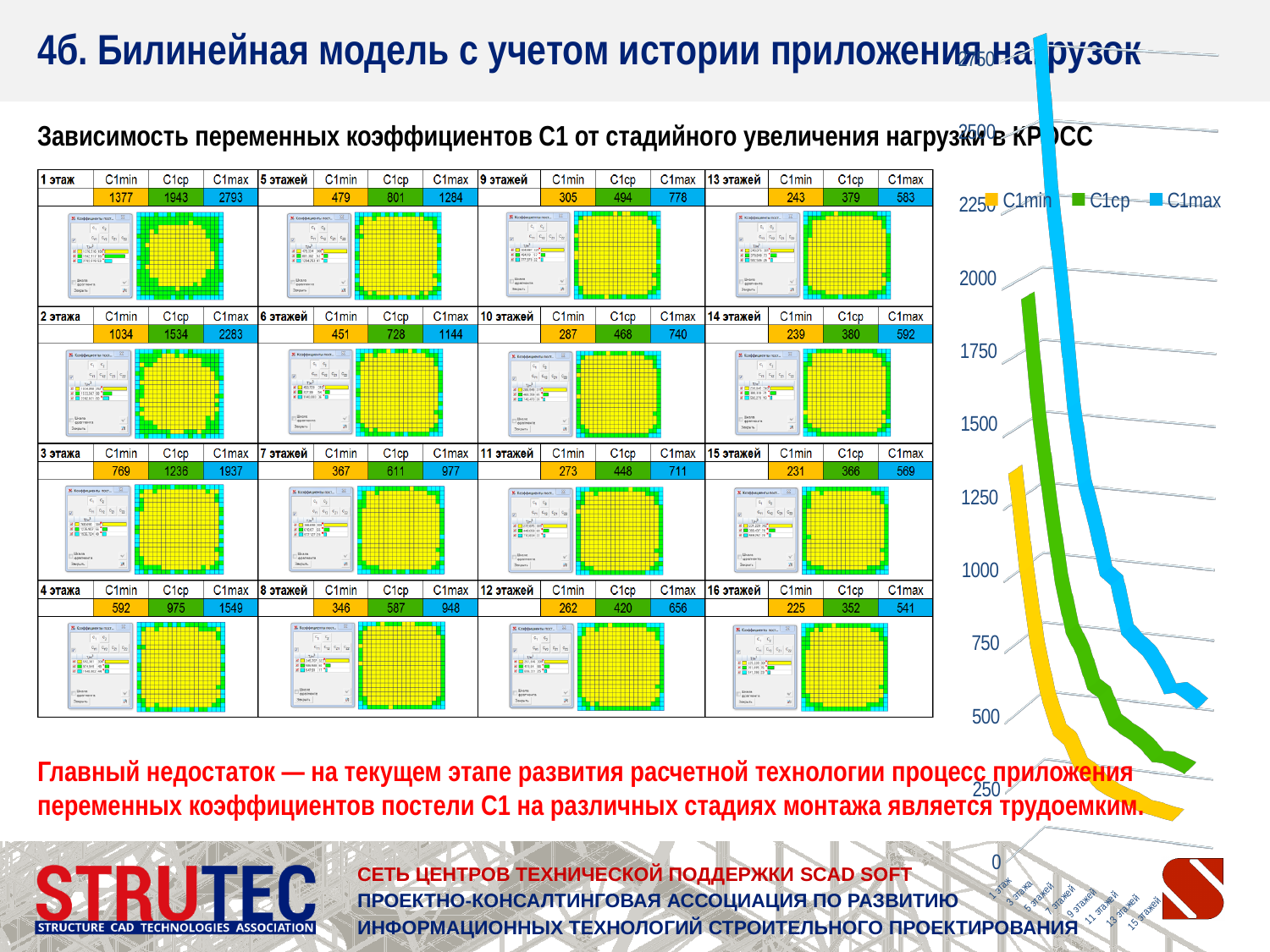
What colour is the C1cp series in the line chart? green In the line chart, is the value of C1min at 15 этажей greater or less than 500? less In the line chart, is the value of C1cp at 1 этаж greater or less than 1750? greater In the line chart, do the values of C1min rise or fall from 1 этаж to 15 этажей? fall How many series does the legend of the line chart list? 3 In the line chart, do the values of C1max rise or fall as the number of floors increases? fall In the line chart, which is larger at 1 этаж: C1max or C1min? C1max In the line chart, is the value of C1min at 1 этаж greater or less than 1250? greater Which series in the line chart has the highest values across all floors? C1max What kind of chart is shown on the right side of the slide? line chart Which series in the line chart has the lowest values across all floors? C1min